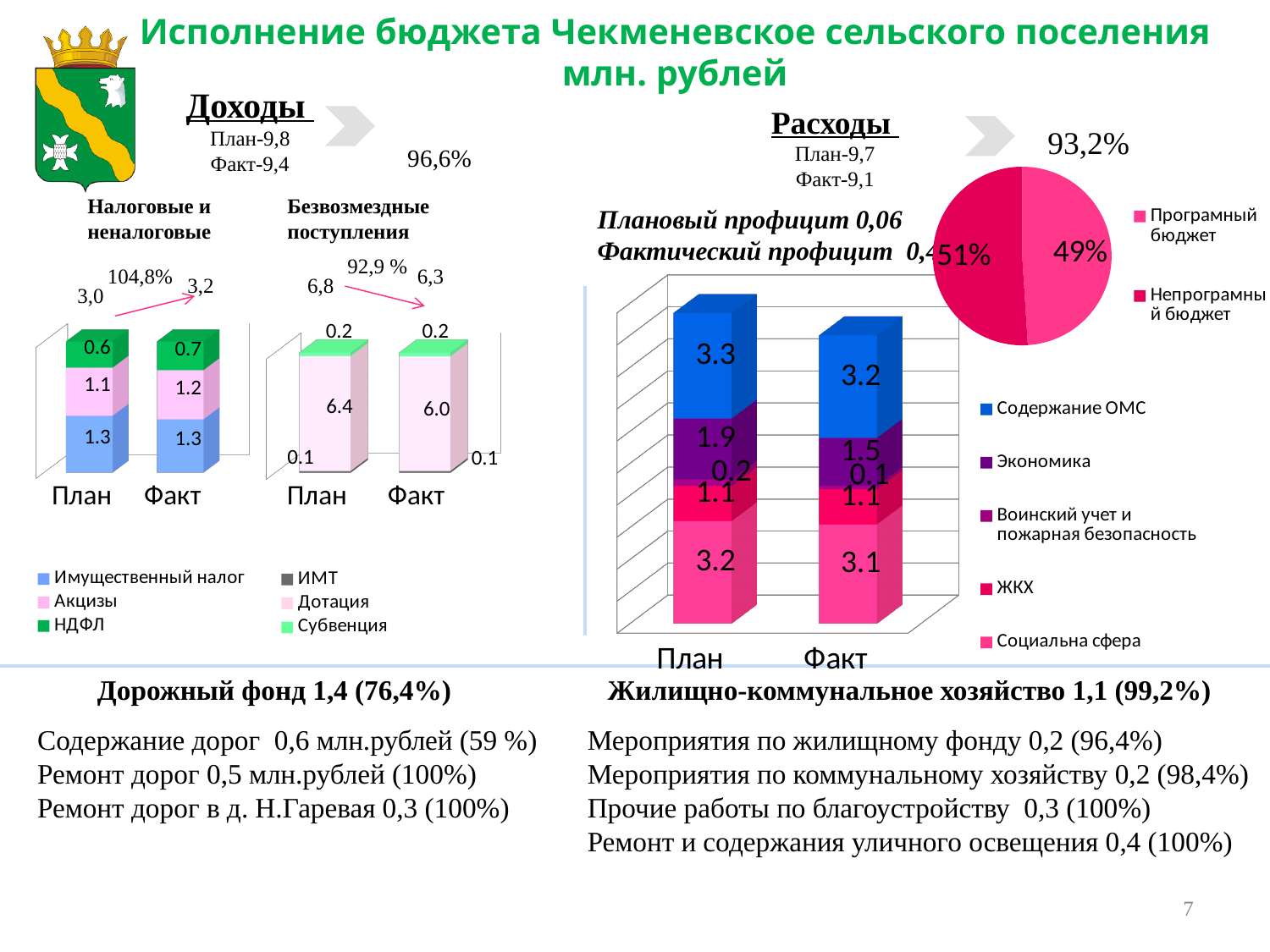
How many series does the legend of the 'Расходы' stacked bar chart list? 5 In the 'Расходы' stacked bar chart, which is larger: Социальна сфера for План or Социальна сфера for Факт? План In the 'Расходы' stacked bar chart, what is the value of Экономика for Факт? 1.5 In the 'Расходы' stacked bar chart, what is the value of Содержание ОМС for План? 3.3 In the pie chart, what share does Программный бюджет have? 49% In the 'Налоговые и неналоговые' chart, what is the value of Акцизы for Факт? 1.2 In the 'Налоговые и неналоговые' chart, what is the total of the Факт stacked bar as labelled on the slide? 3,2 How many series does the legend of the 'Безвозмездные поступления' chart list? 3 In the 'Налоговые и неналоговые' chart, what is the value of НДФЛ for План? 0.6 What kind of chart shows the split between Программный бюджет and Непрограммный бюджет? Pie chart In the 'Безвозмездные поступления' chart, what is the difference between Дотация for План and Дотация for Факт? 0.4 In the 'Безвозмездные поступления' chart, what is the value of Дотация for Факт? 6.0